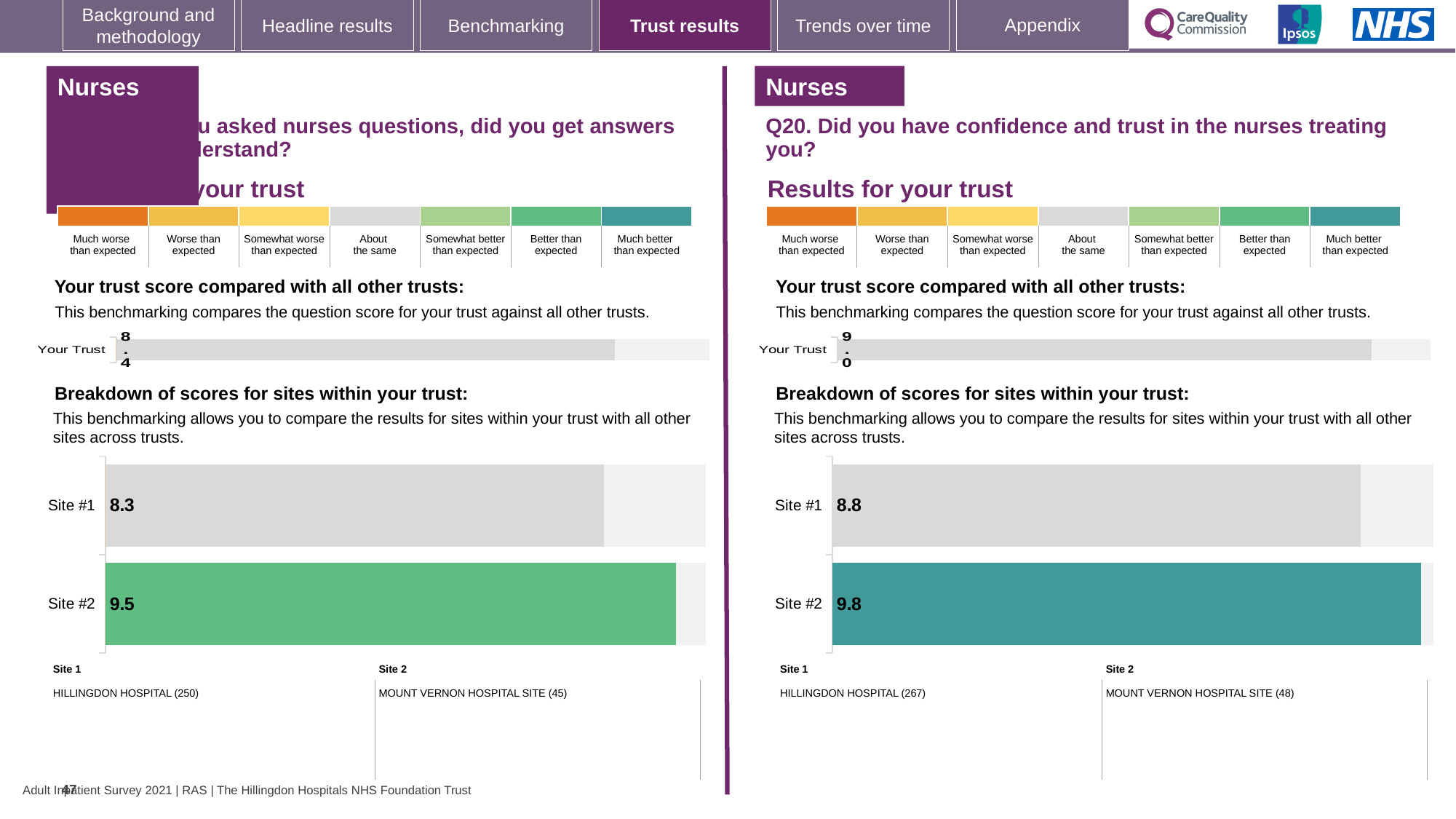
On the left-hand site breakdown chart, what is the difference between the Site #2 and Site #1 scores? 1.2 On the right-hand (Q20) 'Breakdown of scores for sites within your trust' chart, what is the score for Site #1? 8.8 On the right-hand (Q20) site breakdown chart, which site has the lower score? Site #1 On the left-hand site breakdown chart, which site has the higher score? Site #2 On the left-hand 'Your trust score compared with all other trusts' chart, what is the score for Your Trust? 8.4 On the left-hand 'Breakdown of scores for sites within your trust' chart, what is the score for Site #1? 8.3 On the right-hand (Q20) site breakdown chart, what is the difference between the Site #2 and Site #1 scores? 1.0 What kind of chart is the left-hand site breakdown chart? Bar chart How many sites are shown on the right-hand (Q20) site breakdown chart? 2 On the right-hand (Q20) 'Your trust score compared with all other trusts' chart, what is the score for Your Trust? 9.0 On the right-hand (Q20) 'Breakdown of scores for sites within your trust' chart, what is the score for Site #2? 9.8 On the left-hand 'Breakdown of scores for sites within your trust' chart, what is the score for Site #2? 9.5